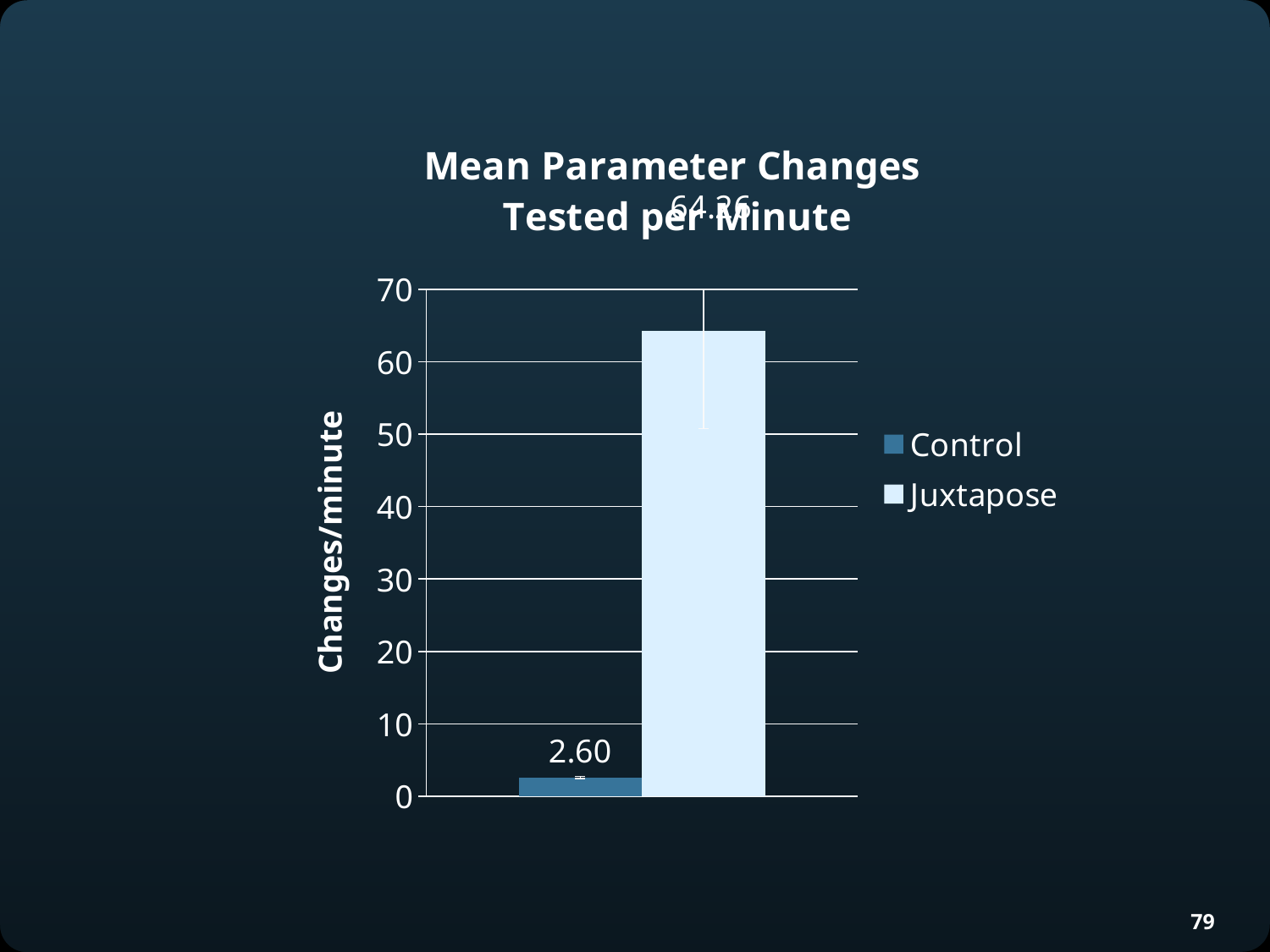
Which series has the lowest value? Control What is the title of the chart? Mean Parameter Changes Tested per Minute Is the value for Control greater or less than 10? less What is the value for Control in the chart? 2.60 How many bars are plotted in the chart? 2 What kind of chart is shown on the slide? bar chart Which is larger, the value for Control or the value for Juxtapose? Juxtapose How many series does the legend list? 2 Is the value for Juxtapose greater or less than 70? less What is the label on the vertical axis? Changes/minute Which series has the highest value? Juxtapose Is the value for Juxtapose greater or less than 60? greater